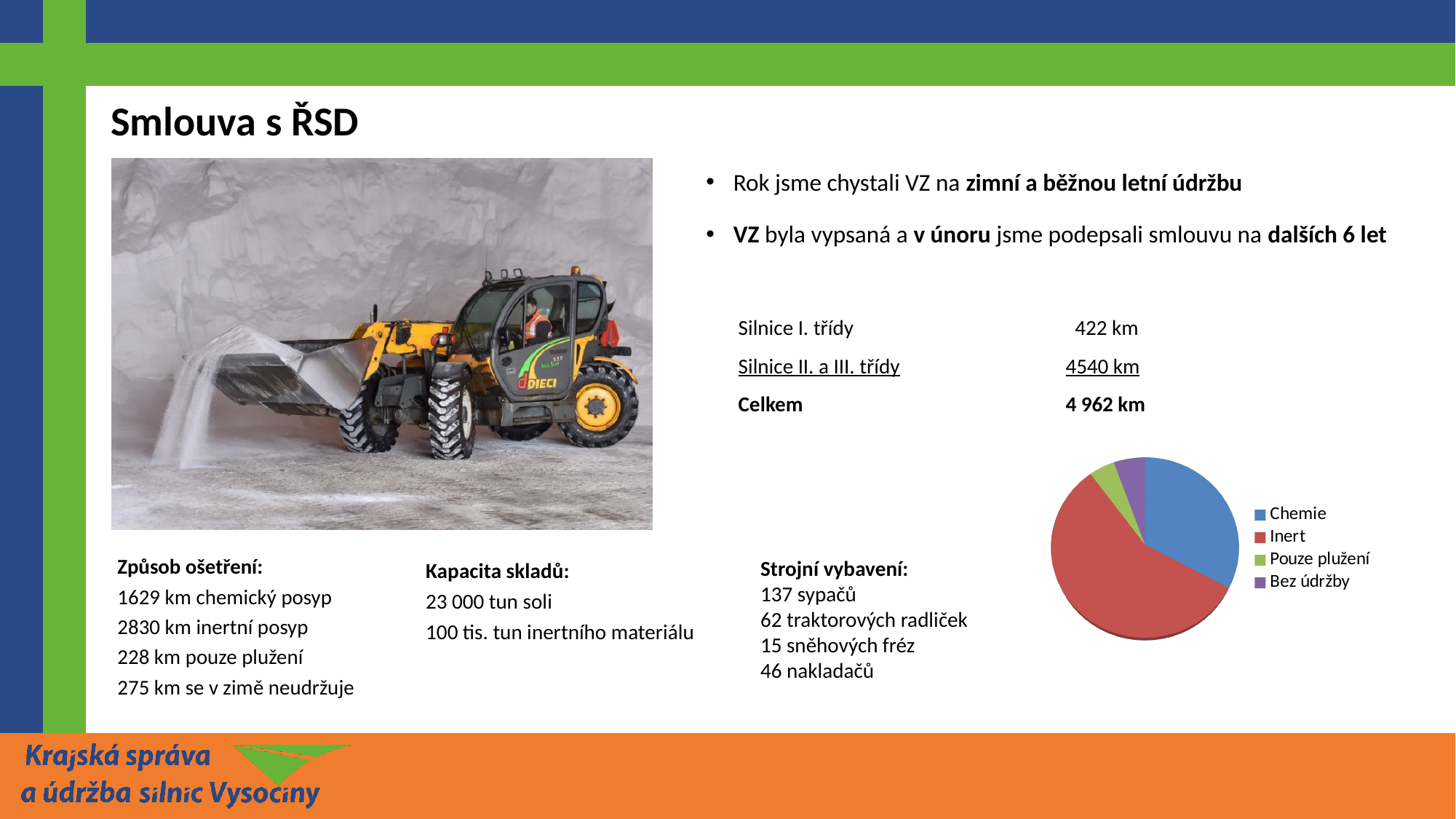
In the pie chart, which slice is larger, Inert or Bez údržby? Inert In the pie chart, which slice is larger, Chemie or Pouze plužení? Chemie Which category has the largest slice in the pie chart? Inert How many entries does the legend of the pie chart list? 4 Which colour represents Inert in the pie chart? red In the pie chart, which slice is larger, Inert or Chemie? Inert What kind of chart is shown on the slide? pie chart Which legend entry is shown in blue in the pie chart? Chemie How many slices does the pie chart have? 4